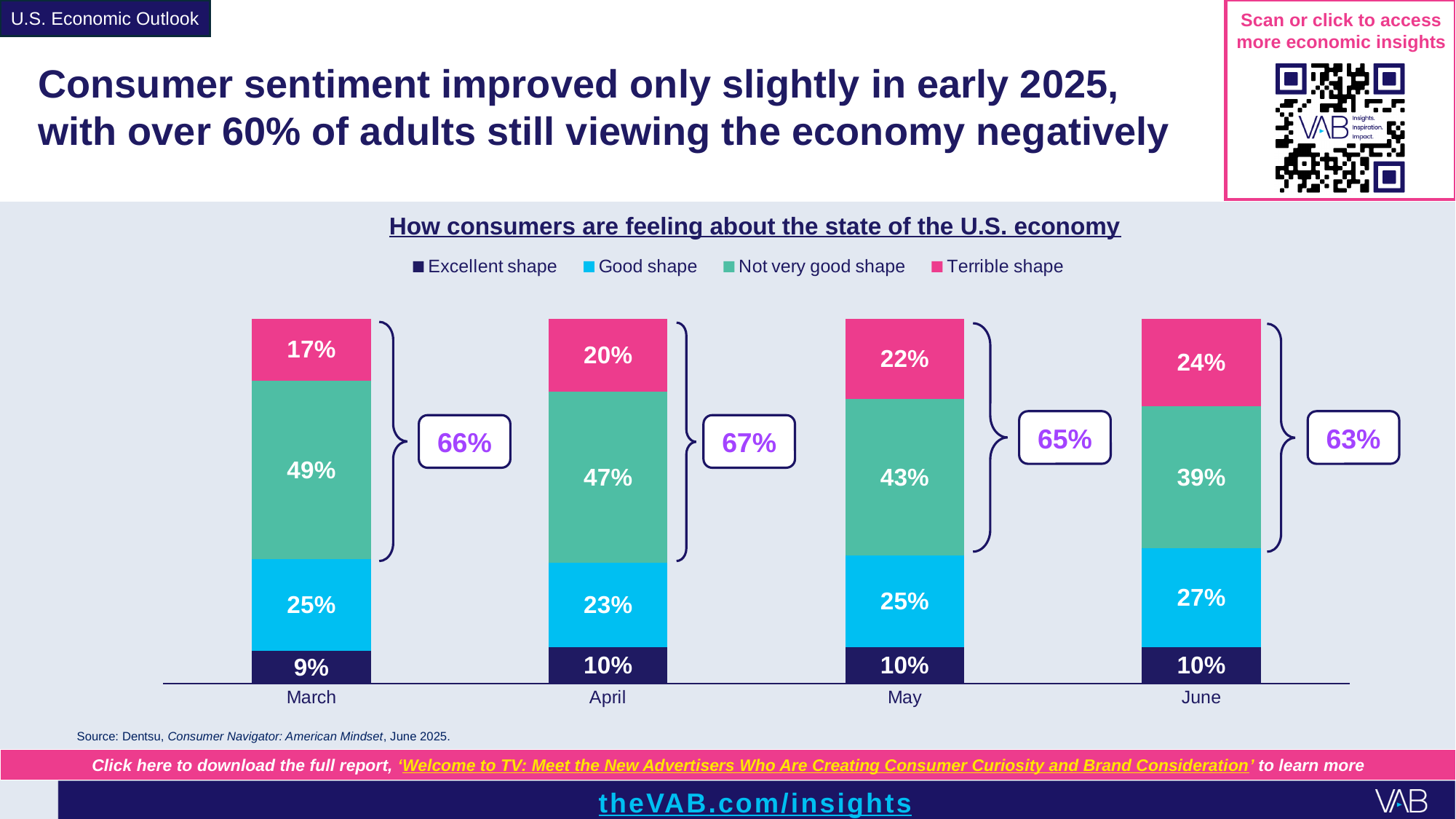
What percentage of consumers said the economy was in 'Terrible shape' in June? 24% What percentage of consumers said the economy was in 'Good shape' in April? 23% In which month was the 'Not very good shape' share the lowest? June What percentage of consumers said the economy was in 'Excellent shape' in March? 9% How many months are shown on the x axis? 4 What percentage of consumers said the economy was in 'Not very good shape' in March? 49% What is the combined share of 'Not very good shape' and 'Terrible shape' in May, as shown in the callout? 65% What is the difference between the 'Not very good shape' share in March and in June? 10 percentage points How many series does the legend list? 4 In which month was the 'Terrible shape' share the highest? June Which is larger: the 'Good shape' share in June or in April? June What kind of chart is shown on the slide? Stacked bar chart